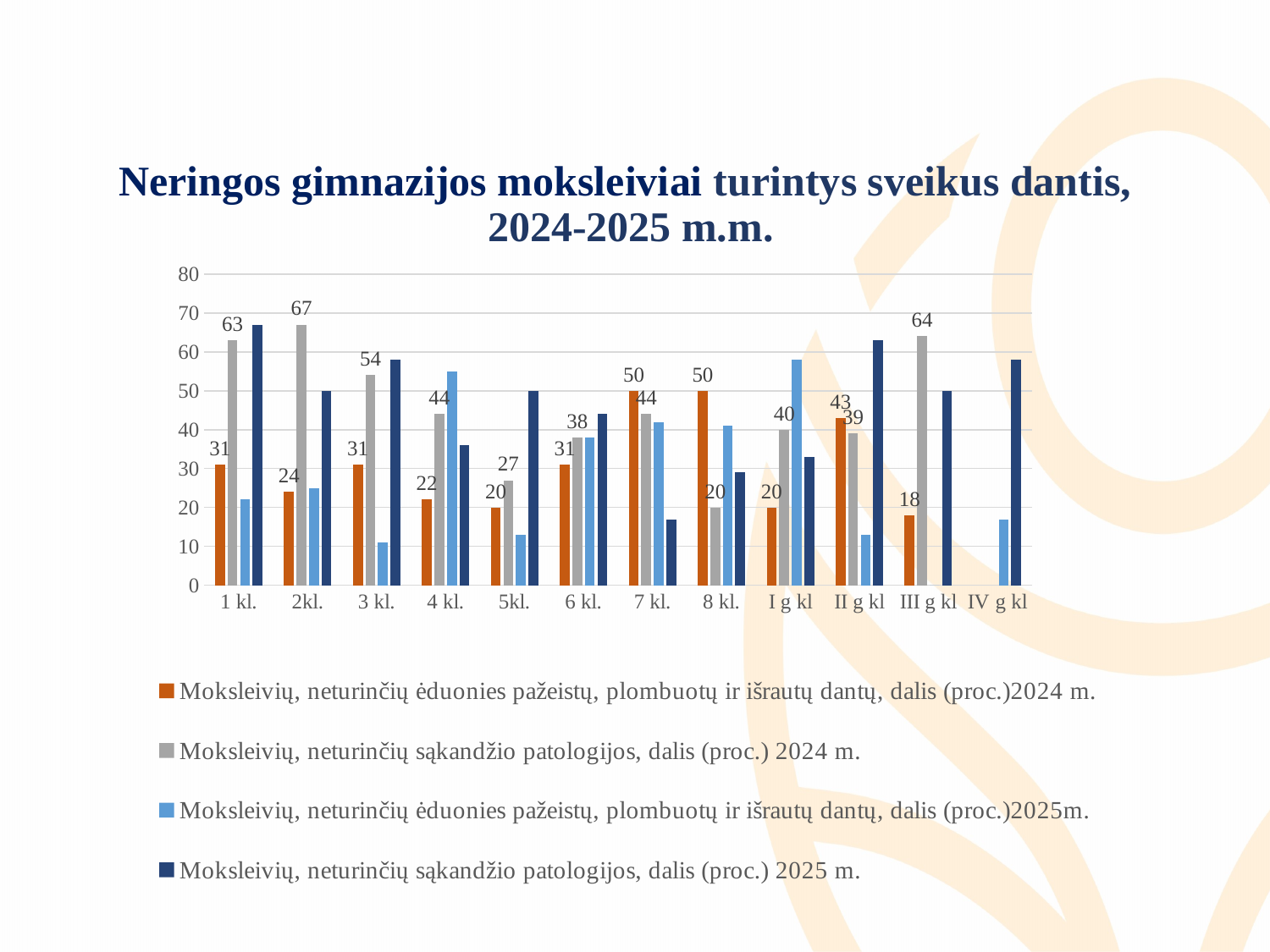
Which class has the highest value in the series "Moksleivių, neturinčių sąkandžio patologijos, dalis (proc.) 2024 m."? 2kl. Which class has the lowest value in the series "Moksleivių, neturinčių ėduonies pažeistų, plombuotų ir išrautų dantų, dalis (proc.)2024 m."? III g kl What is the value for 2kl. in the series "Moksleivių, neturinčių sąkandžio patologijos, dalis (proc.) 2024 m."? 67 What is the value for III g kl in the series "Moksleivių, neturinčių sąkandžio patologijos, dalis (proc.) 2024 m."? 64 For 1 kl., what is the difference between the 2024 "neturinčių sąkandžio patologijos" value and the 2024 "neturinčių ėduonies pažeistų, plombuotų ir išrautų dantų" value? 32 For II g kl, which 2024 series has the larger value: "neturinčių ėduonies pažeistų, plombuotų ir išrautų dantų" or "neturinčių sąkandžio patologijos"? Moksleivių, neturinčių ėduonies pažeistų, plombuotų ir išrautų dantų, dalis (proc.)2024 m. Is the value for I g kl in the series "Moksleivių, neturinčių ėduonies pažeistų, plombuotų ir išrautų dantų, dalis (proc.)2025m." greater or less than 50? greater What kind of chart is shown on the slide? bar chart How many series does the legend list? 4 Is the value for 7 kl. in the series "Moksleivių, neturinčių sąkandžio patologijos, dalis (proc.) 2025 m." greater or less than 20? less How many classes are shown on the x axis of the chart? 12 What is the value for 7 kl. in the series "Moksleivių, neturinčių ėduonies pažeistų, plombuotų ir išrautų dantų, dalis (proc.)2024 m."? 50